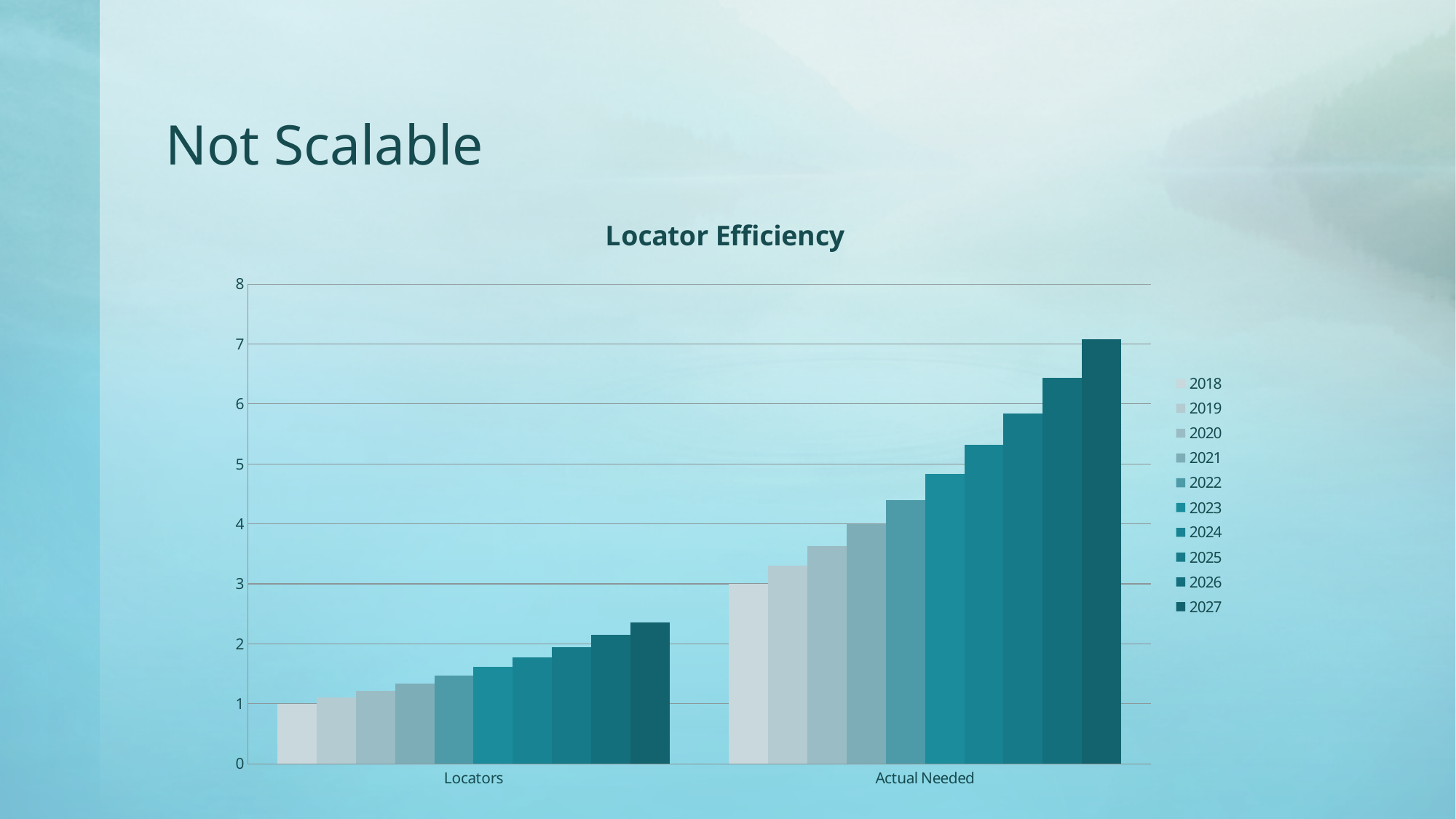
Is the value for 2023 in the Locators category greater or less than 2? less Which is larger for 2027: the Locators value or the Actual Needed value? Actual Needed Within the Actual Needed category, do the values rise or fall from 2018 to 2027? rise How many series does the legend list? 10 How many categories are shown on the x axis? 2 Which year has the highest value in the Actual Needed category? 2027 What is the title of the chart? Locator Efficiency Is the value for 2027 in the Actual Needed category greater or less than 6? greater Is the value for 2027 in the Locators category greater or less than 2? greater Which year has the lowest value in the Locators category? 2018 What kind of chart is shown on the slide? bar chart